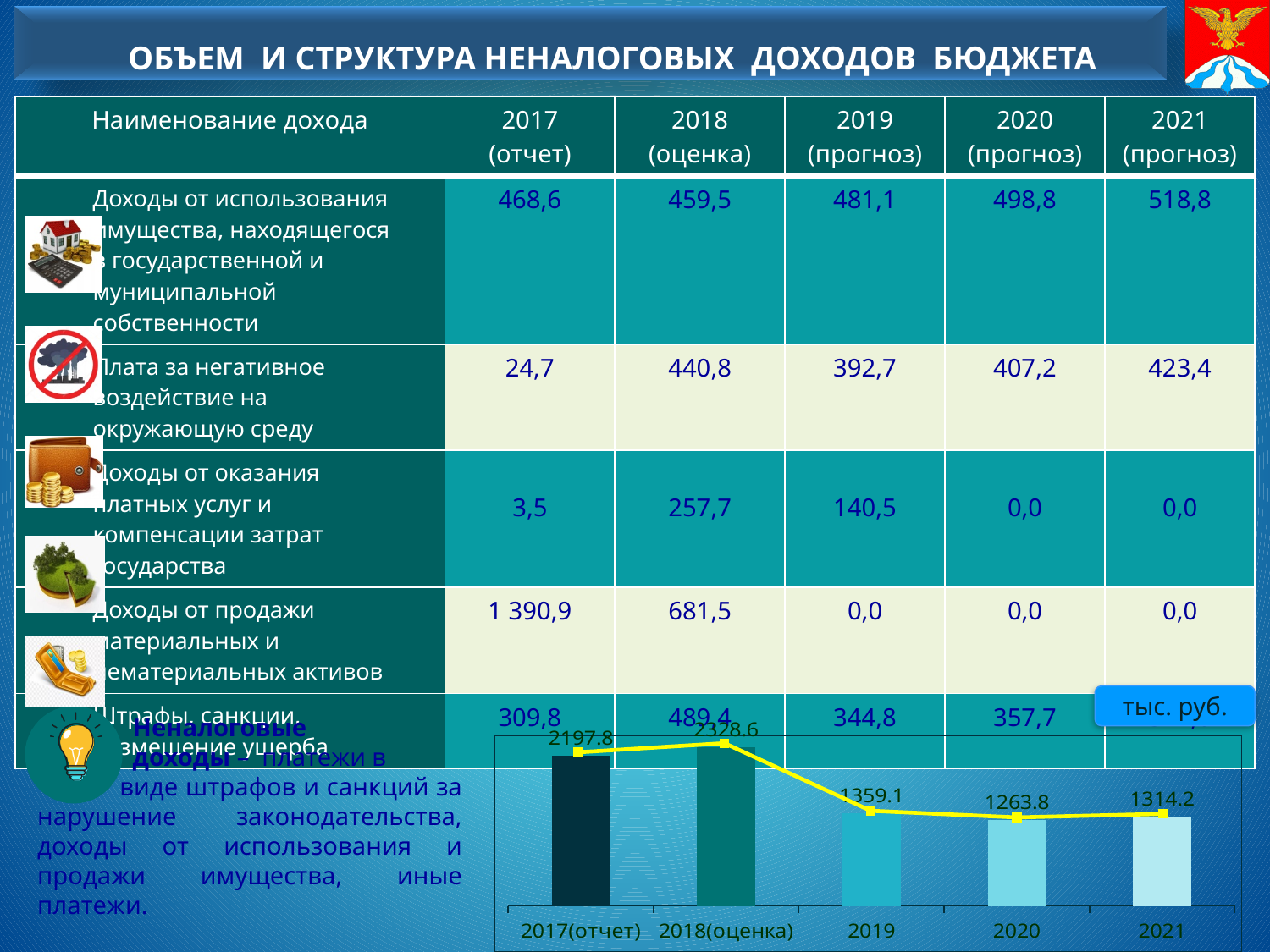
In the chart at the bottom of the slide, what is the value for 2018(оценка)? 2328.6 In the chart at the bottom of the slide, what is the difference between the values for 2018(оценка) and 2017(отчет)? 130.8 In the chart at the bottom of the slide, what is the difference between the values for 2019 and 2020? 95.3 In the chart at the bottom of the slide, which is larger, the value for 2019 or the value for 2021? 2019 What unit is indicated for the chart at the bottom of the slide? тыс. руб. In the chart at the bottom of the slide, what is the value for 2020? 1263.8 In the chart at the bottom of the slide, which year has the highest value? 2018(оценка) In the chart at the bottom of the slide, which year has the lowest value? 2020 What kind of chart is shown at the bottom of the slide? bar chart with a line How many categories (years) are shown in the chart at the bottom of the slide? 5 In the chart at the bottom of the slide, do the values rise or fall from 2018(оценка) to 2020? fall In the chart at the bottom of the slide, what is the value for 2017(отчет)? 2197.8